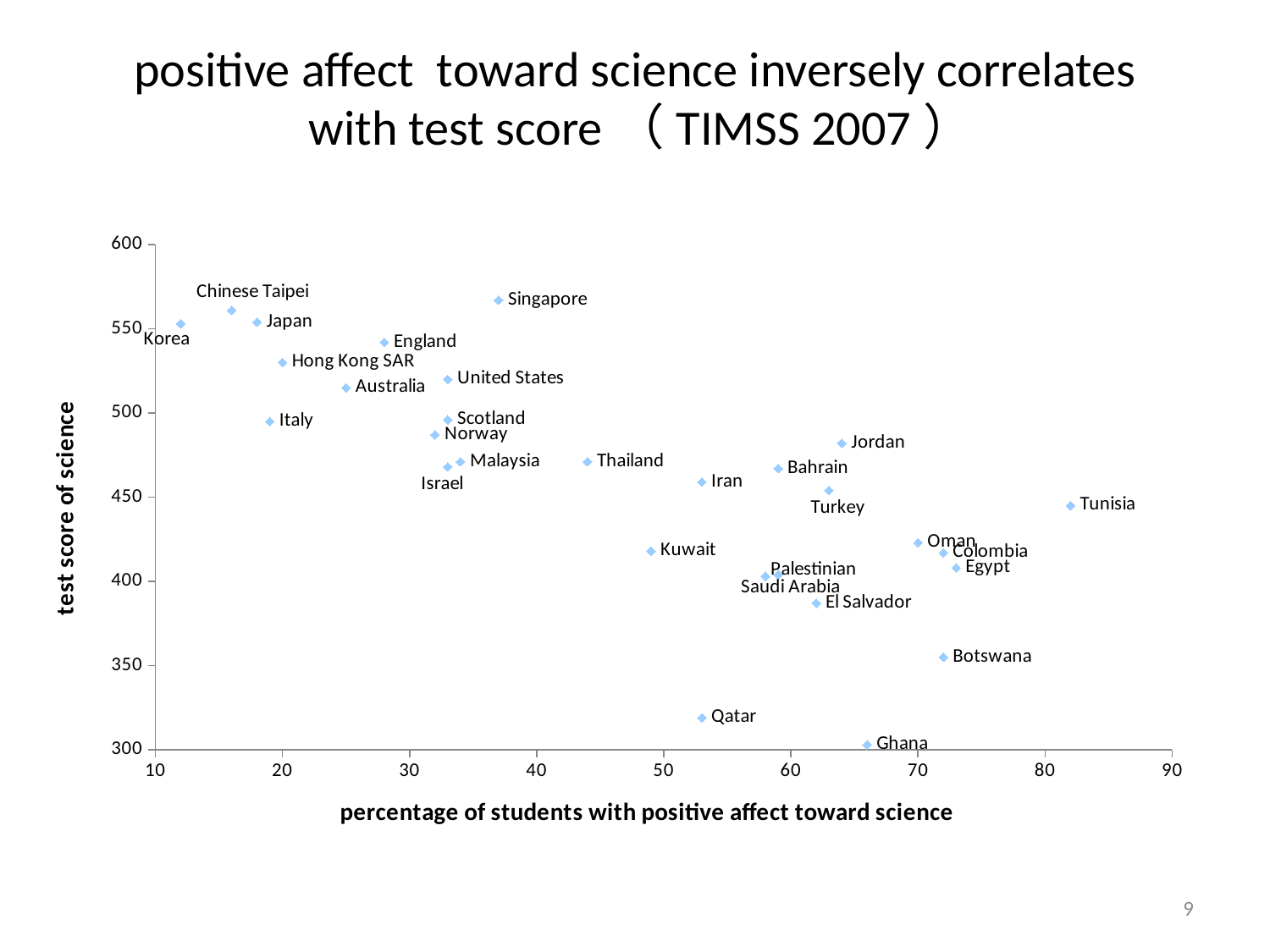
Which country has the lowest percentage of students with positive affect toward science? Korea Overall, do test scores rise or fall as the percentage of students with positive affect toward science increases? fall Is the test score of science for Singapore greater or less than 550? greater Is the percentage of students with positive affect toward science for Tunisia greater or less than 80? greater What kind of chart is shown on the slide? scatter chart Which country has the highest percentage of students with positive affect toward science? Tunisia How many countries are plotted on the chart? 29 Which has the higher test score of science, Japan or Italy? Japan What is the title of the vertical axis? test score of science Is the test score of science for Ghana greater or less than 350? less Which has the higher test score of science, Botswana or Qatar? Botswana Which country has the lowest test score of science on the chart? Ghana